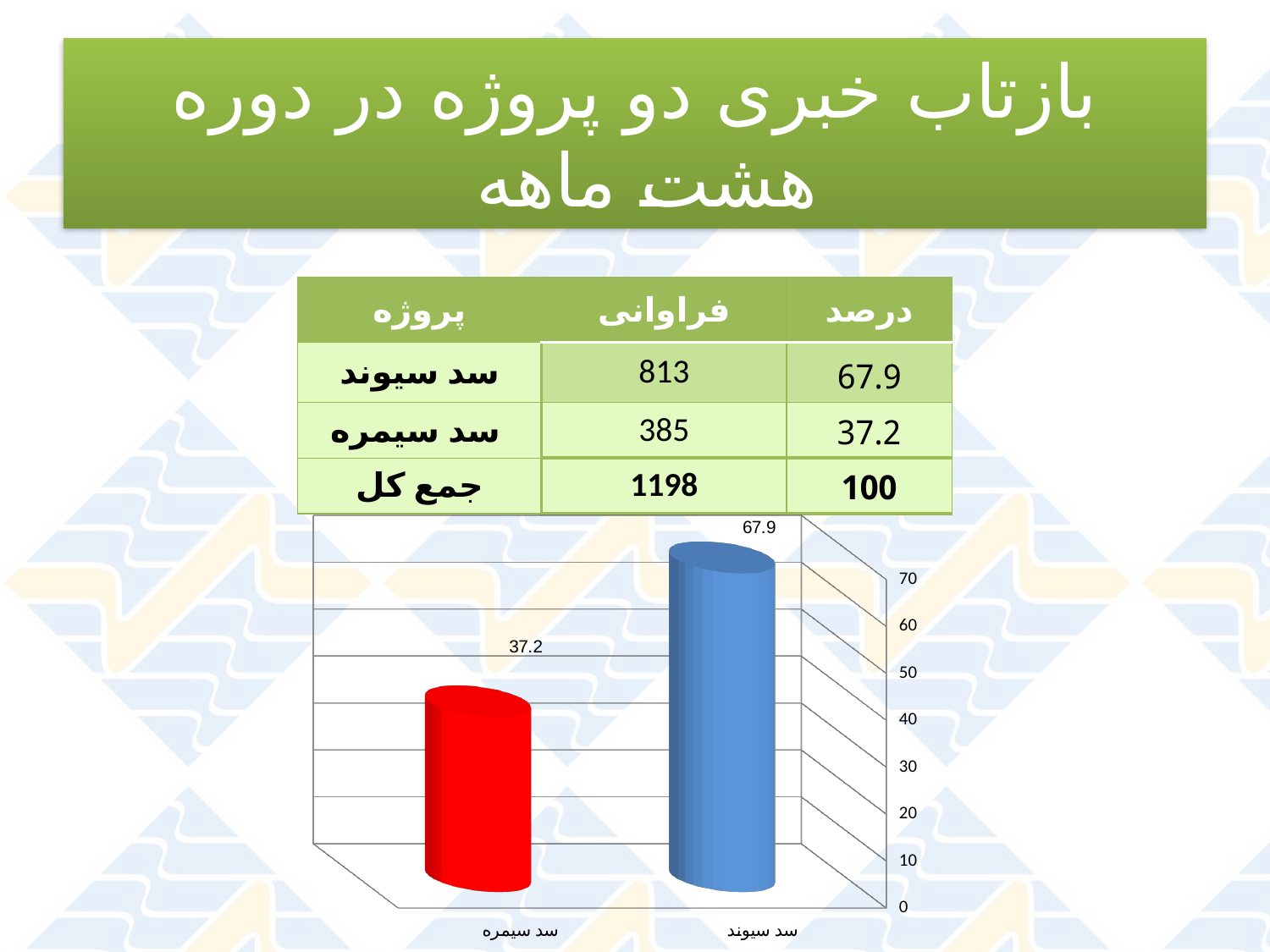
What colour is the bar for سد سیمره in the chart? red What is the highest tick value shown on the chart's vertical axis? 70 What is the difference between the values for سد سیوند and سد سیمره in the chart? 30.7 Which category has the lowest bar in the chart? سد سیمره How many categories are plotted in the chart? 2 Which is larger in the chart, the value for سد سیمره or the value for سد سیوند? سد سیوند Which category has the highest bar in the chart? سد سیوند Is the value for سد سیمره in the chart greater or less than 40? less Is the value for سد سیوند in the chart greater or less than 60? greater What is the value shown for سد سیمره in the chart? 37.2 What kind of chart is shown on the slide? bar chart What is the value shown for سد سیوند in the chart? 67.9